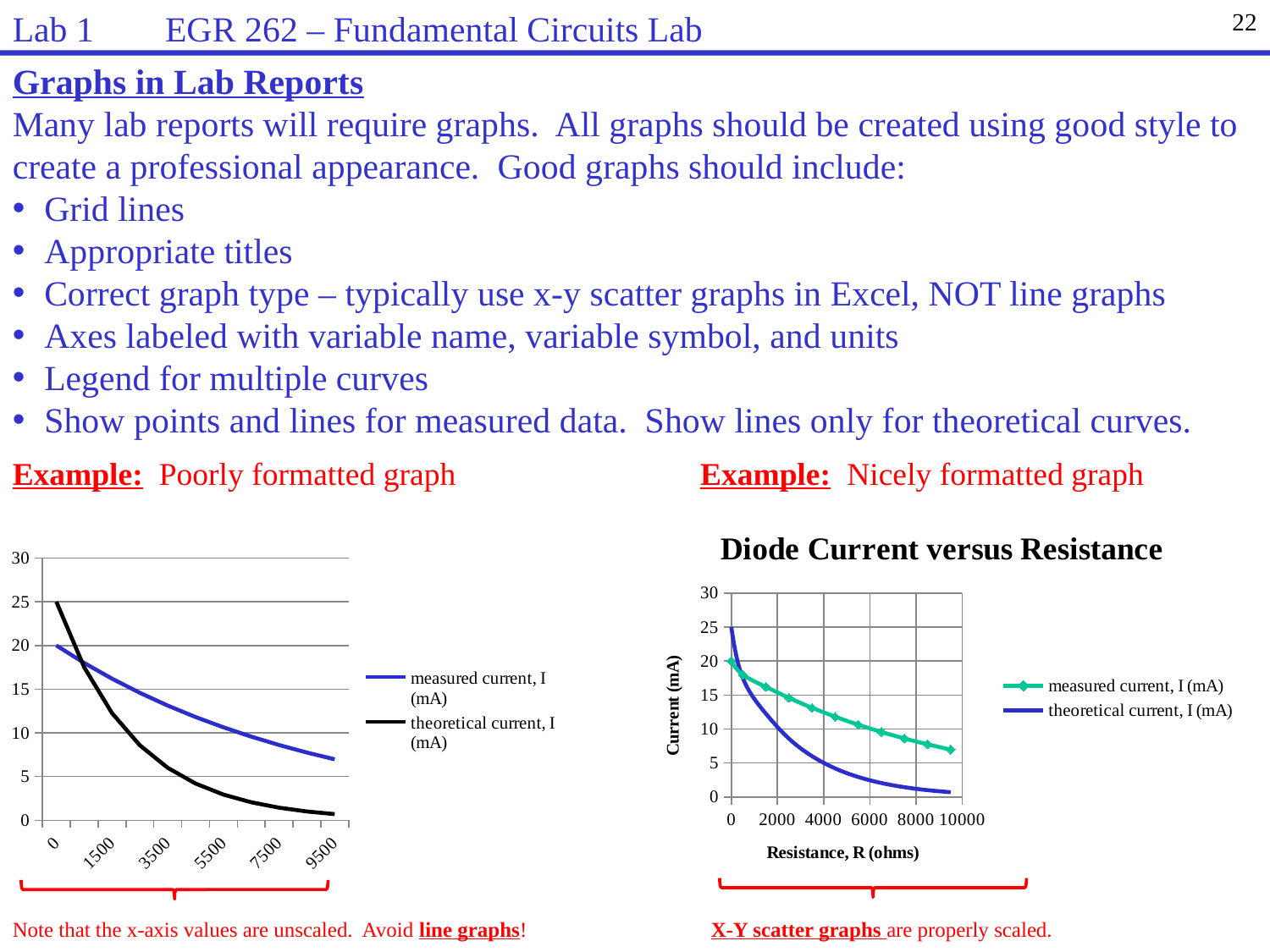
In the 'Diode Current versus Resistance' chart, is the theoretical current at 8000 ohms greater or less than 5? less In the 'Diode Current versus Resistance' chart, how many series does the legend list? 2 In the chart on the left (poorly formatted graph), does the theoretical current rise or fall along the x axis? fall In the 'Diode Current versus Resistance' chart, at a resistance of 8000 ohms, which series has the larger current: measured or theoretical? measured current, I (mA) In the chart on the left (poorly formatted graph), how many series does the legend list? 2 What is the x-axis label of the 'Diode Current versus Resistance' chart? Resistance, R (ohms) In the 'Diode Current versus Resistance' chart, does the measured current rise or fall as resistance increases? fall In the 'Diode Current versus Resistance' chart, what is the theoretical current at a resistance of 0 ohms? 25 In the chart on the left (poorly formatted graph), at x = 0, which series has the larger value: measured current or theoretical current? theoretical current, I (mA) In the 'Diode Current versus Resistance' chart, what is the measured current at a resistance of 0 ohms? 20 What is the title of the chart on the right side of the slide? Diode Current versus Resistance